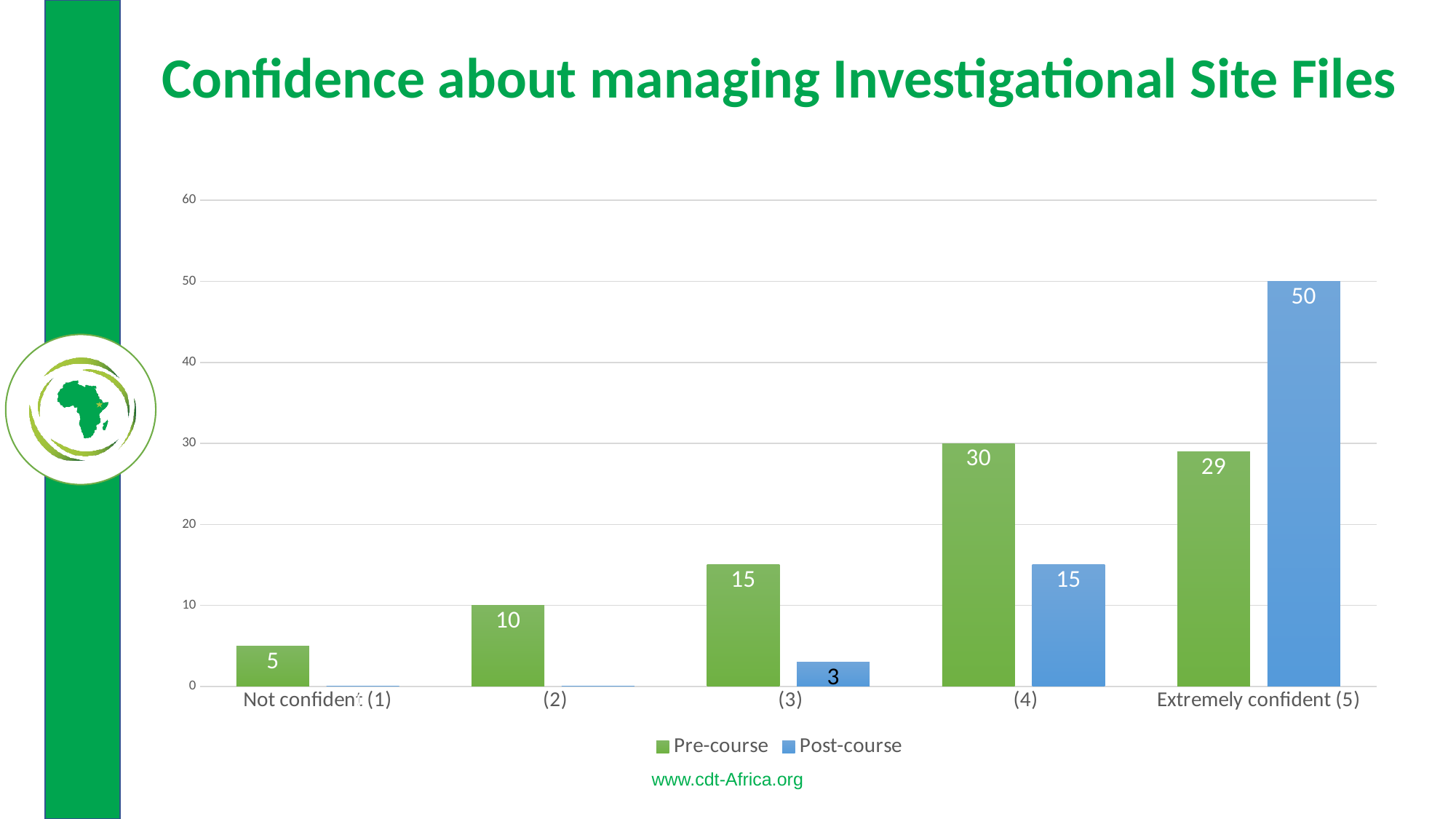
What is the Pre-course value for Extremely confident (5)? 29 Which category has the highest Pre-course value? (4) Which is larger for category (4): the Pre-course value or the Post-course value? Pre-course What is the Post-course value for category (3)? 3 How many categories are shown on the x axis? 5 What kind of chart is shown on the slide? Bar chart What is the Post-course value for Extremely confident (5)? 50 What is the Pre-course value for Not confident (1)? 5 What is the title of the chart? Confidence about managing Investigational Site Files How many series does the legend list? 2 What is the difference between the Post-course and Pre-course values for Extremely confident (5)? 21 Which category has the lowest Pre-course value? Not confident (1)